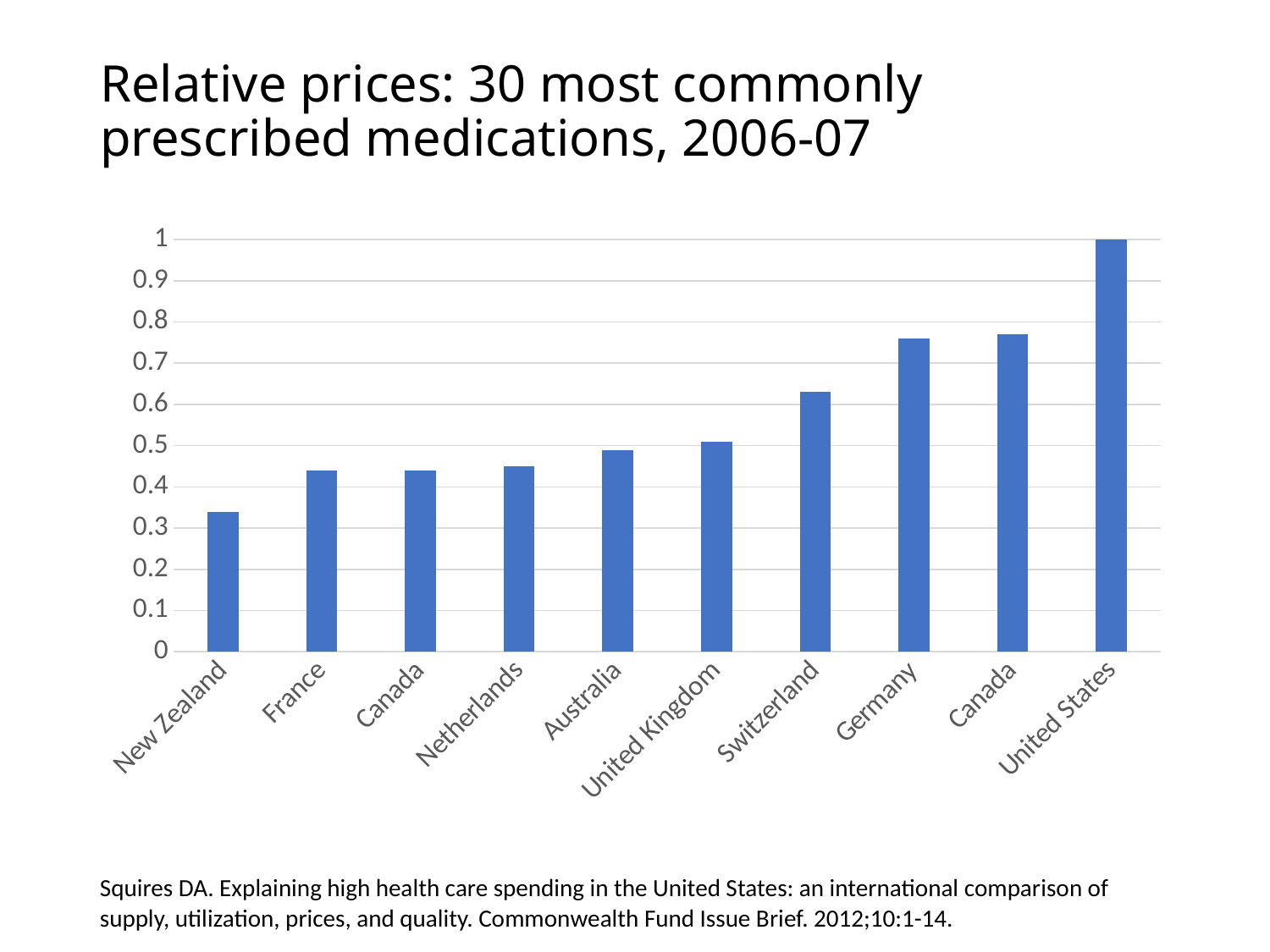
Is the value for New Zealand greater or less than 0.4? less Is the value for France greater or less than 0.5? less How many bars are plotted in the chart? 10 What is the relative price value for the United States? 1 Is the value for Switzerland greater or less than 0.6? greater Do the values generally rise or fall moving from left to right along the x axis? rise Which country has the lowest relative price? New Zealand Which country has the highest relative price? United States Which has a higher relative price, Switzerland or France? Switzerland What is the title of the slide? Relative prices: 30 most commonly prescribed medications, 2006-07 What kind of chart is shown on the slide? bar chart